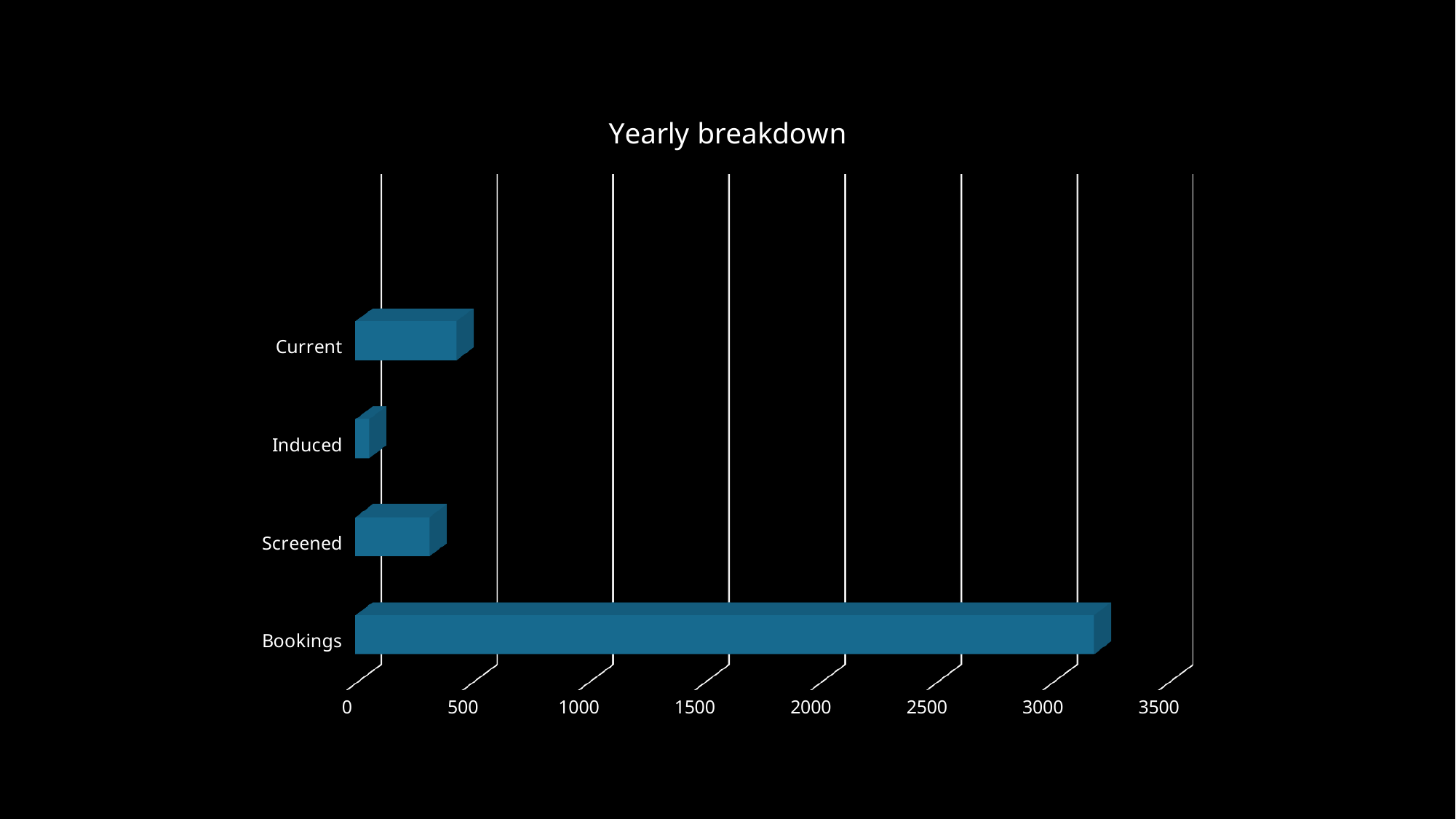
Which category has the lowest value? Induced What is the title of the chart? Yearly breakdown Which is larger, the value for Bookings or the value for Induced? Bookings What is the maximum value shown on the horizontal axis? 3500 Is the value for Screened greater or less than 500? less What kind of chart is shown on the slide? Bar chart How many categories are plotted in the chart? 4 Is the value for Current greater or less than 500? less Which category has the highest value? Bookings Which is larger, the value for Current or the value for Screened? Current Is the value for Induced greater or less than 500? less